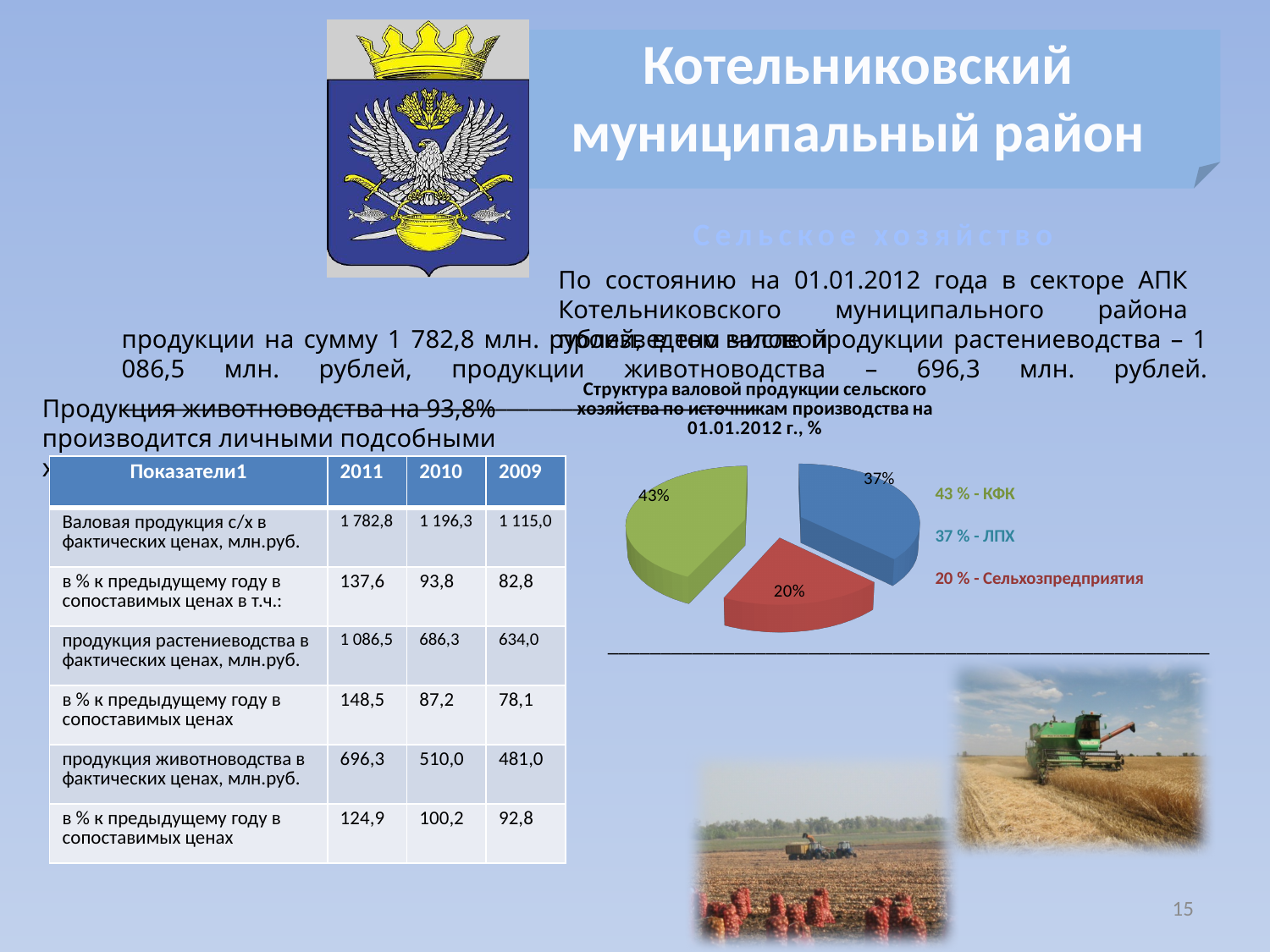
What share of the pie chart is labelled Сельхозпредприятия? 20% Which source has the smallest share in the pie chart? Сельхозпредприятия What colour is the slice representing Сельхозпредприятия in the pie chart? red What share of the pie chart is labelled ЛПХ? 37% What is the difference in percentage points between the КФК share and the ЛПХ share? 6 How many slices does the pie chart have? 3 What is the title of the pie chart? Структура валовой продукции сельского хозяйства по источникам производства на 01.01.2012 г., % Which source has the largest share in the pie chart? КФК Which is larger in the pie chart, the share for ЛПХ or the share for Сельхозпредприятия? ЛПХ What kind of chart is shown on the slide? pie chart What is the difference in percentage points between the ЛПХ share and the Сельхозпредприятия share? 17 What share of the pie chart is labelled КФК? 43%